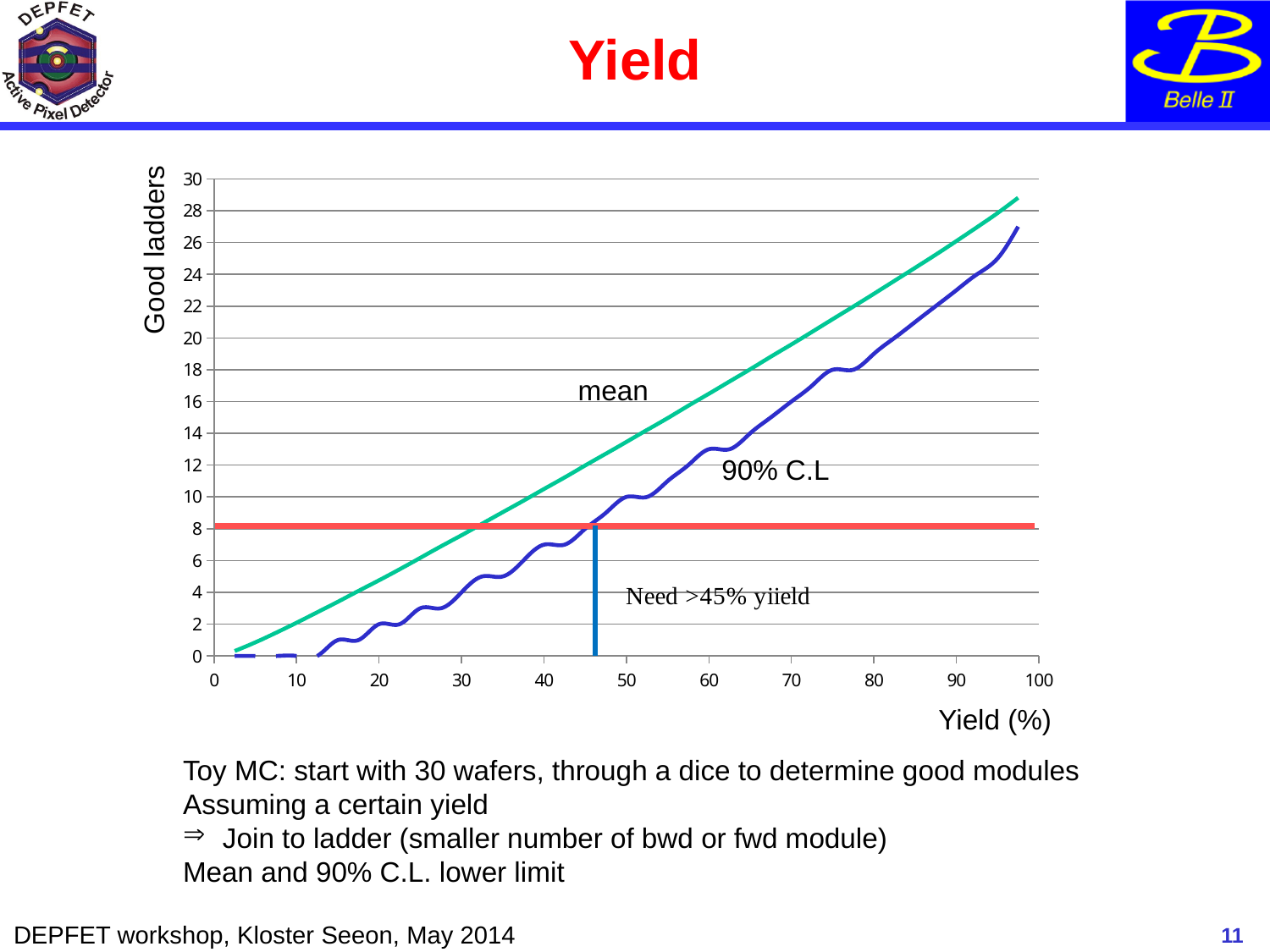
At a yield of 70%, which curve is higher, mean or 90% C.L? mean How many curves are labelled on the chart? 2 Is the value of the mean curve at a yield of 90% greater or less than 20 good ladders? greater Do the values of the mean curve rise or fall as Yield (%) increases? rise Is the value of the 90% C.L curve at a yield of 60% greater or less than 10 good ladders? greater Is the value of the mean curve at a yield of 20% greater or less than 10 good ladders? less What is the label of the y axis? Good ladders What is the title of the slide's chart? Yield What is the label of the x axis? Yield (%) What kind of chart is shown on the slide? line chart